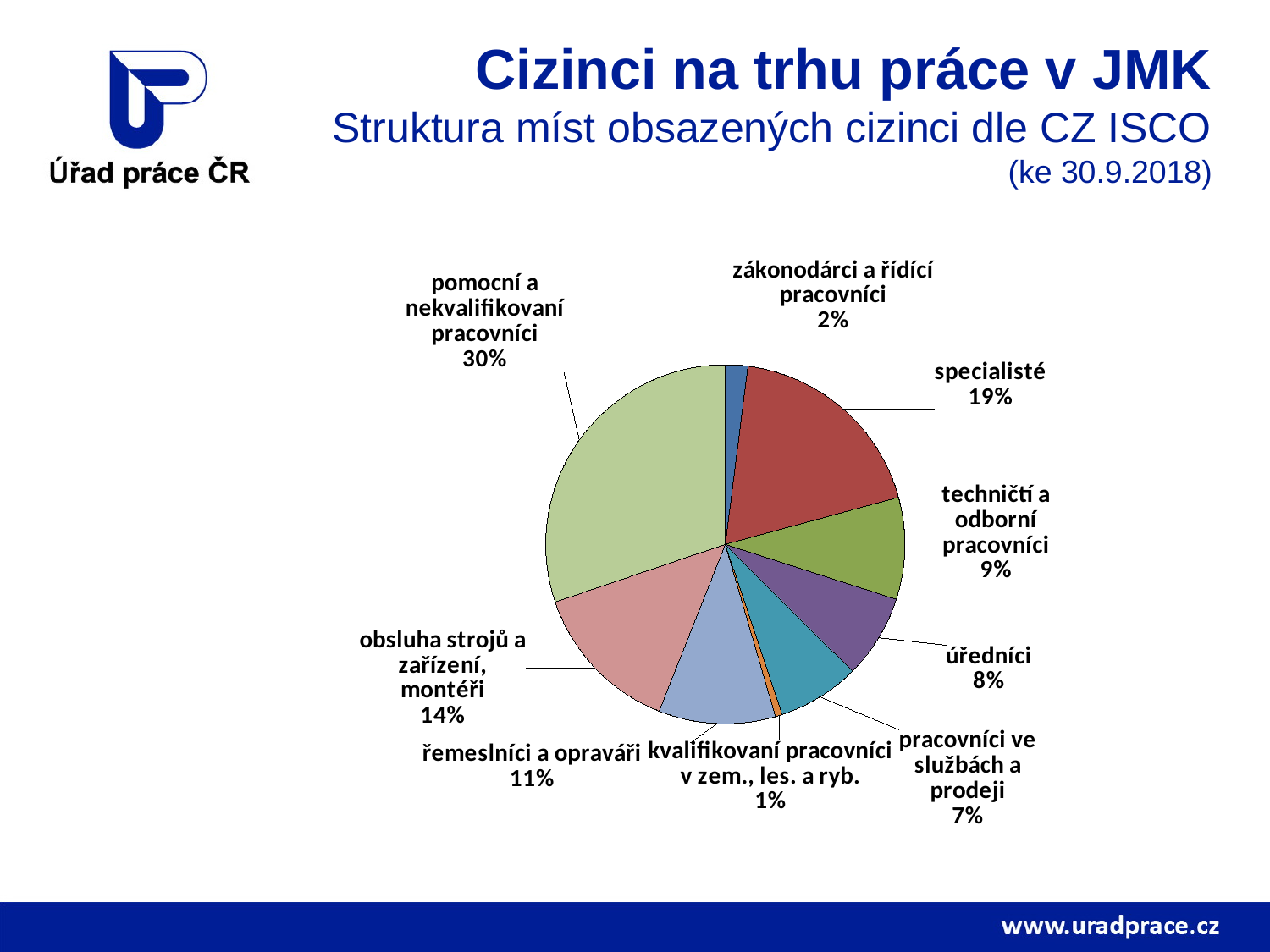
What share of the pie is 'specialisté'? 19% What kind of chart is shown on the slide? pie chart What share of the pie is 'pomocní a nekvalifikovaní pracovníci'? 30% Which is larger, 'techničtí a odborní pracovníci' or 'pracovníci ve službách a prodeji'? techničtí a odborní pracovníci Which category has the largest slice of the pie? pomocní a nekvalifikovaní pracovníci What share of the pie is 'obsluha strojů a zařízení, montéři'? 14% What is the difference in percentage points between 'specialisté' and 'řemeslníci a opraváři'? 8 What date is given in the slide title for the data? 30.9.2018 How many categories are shown in the pie chart? 9 Which category has the smallest slice of the pie? kvalifikovaní pracovníci v zem., les. a ryb.